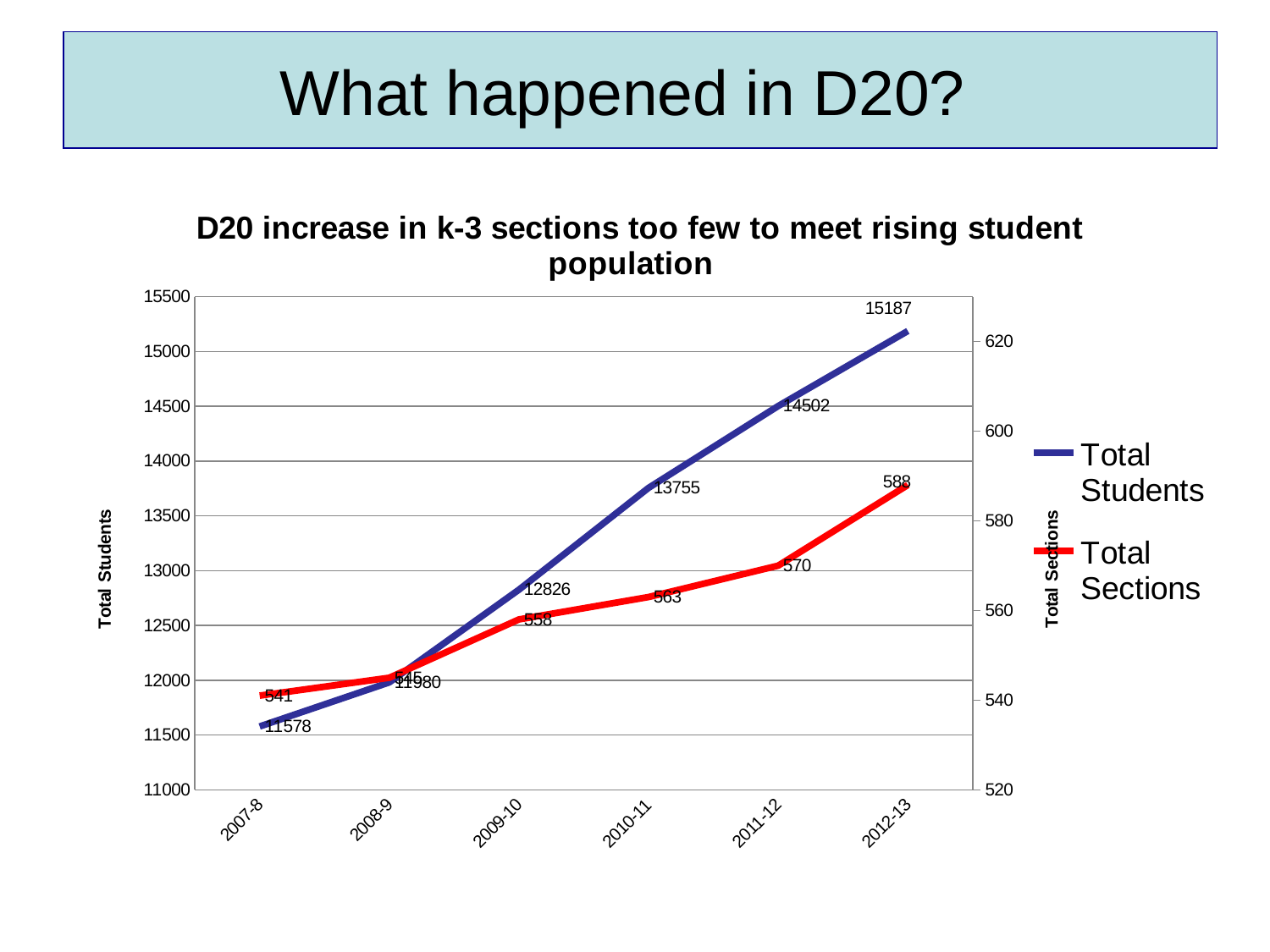
In which school year is Total Sections lowest? 2007-8 What is the difference in Total Sections between 2011-12 and 2012-13? 18 What is the Total Students value for 2012-13? 15187 What is the Total Sections value for 2011-12? 570 What kind of chart is shown on the slide? Line chart In which school year is Total Students highest? 2012-13 What is the Total Sections value for 2009-10? 558 By how much did Total Students increase from 2007-8 to 2012-13? 3609 How many series does the legend list? 2 How many school years are shown on the x axis? 6 Which year has the larger Total Students value, 2009-10 or 2010-11? 2010-11 What is the Total Students value for 2007-8? 11578